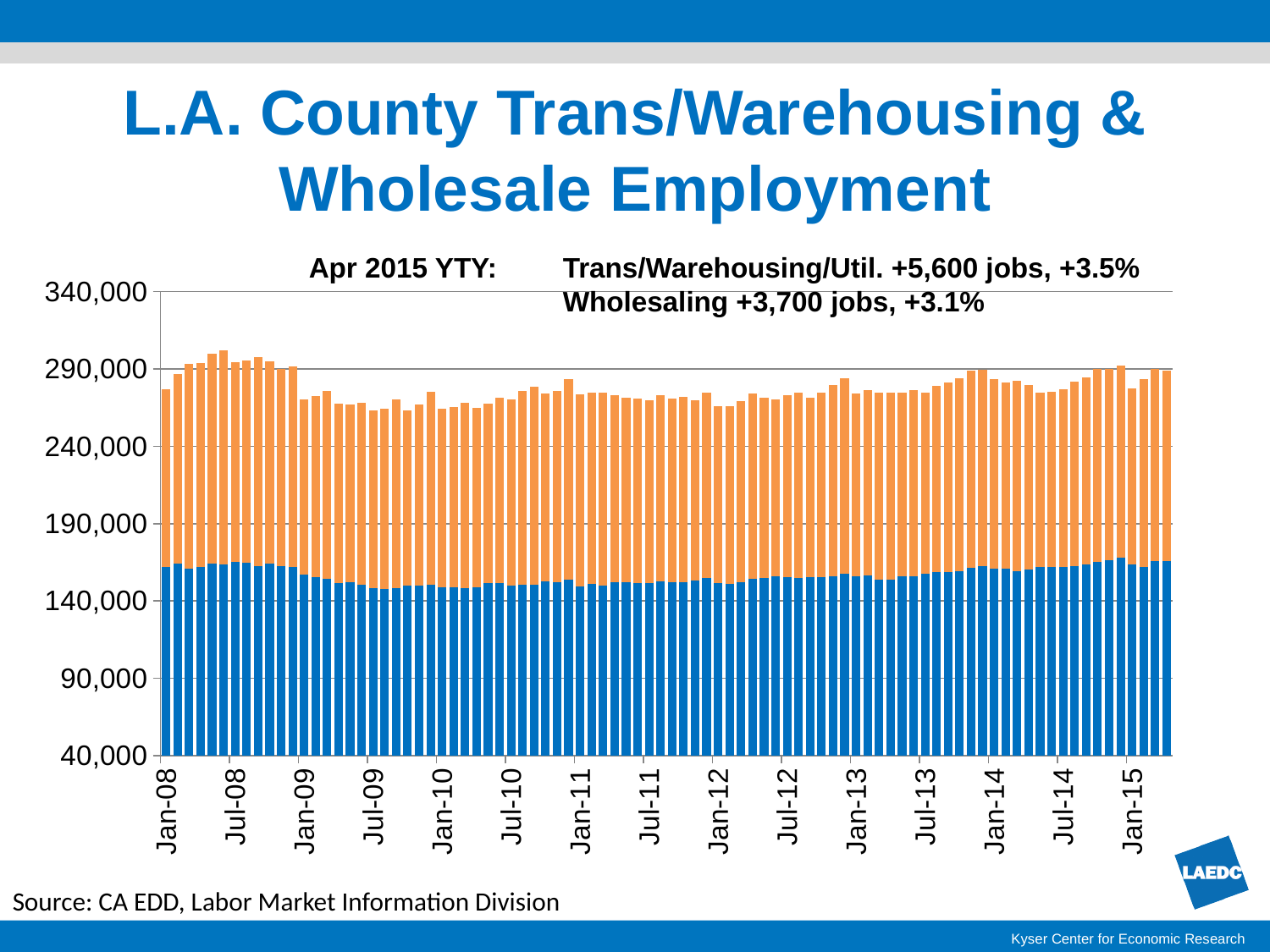
According to the annotation on the chart, what was the Apr 2015 year-to-year percentage change for Wholesaling? +3.1% Is the total height of the stacked bar for Jan-08 greater or less than 240,000? greater Does the total height of the stacked bars rise or fall between Jul-08 and Jul-09? fall What source is cited below the chart? CA EDD, Labor Market Information Division Is the blue (bottom) segment for Jan-15 greater or less than 190,000? less Does the total height of the stacked bars rise or fall between Jan-12 and Jan-15? rise Is the total height of the stacked bar for Jul-08 greater or less than 340,000? less How many coloured segments (series) are stacked in each bar of the chart? 2 What kind of chart is shown on the slide? Stacked bar chart What is the title of the chart on the slide? L.A. County Trans/Warehousing & Wholesale Employment According to the annotation on the chart, how many jobs did Trans/Warehousing/Util. add year-to-year as of Apr 2015? +5,600 jobs